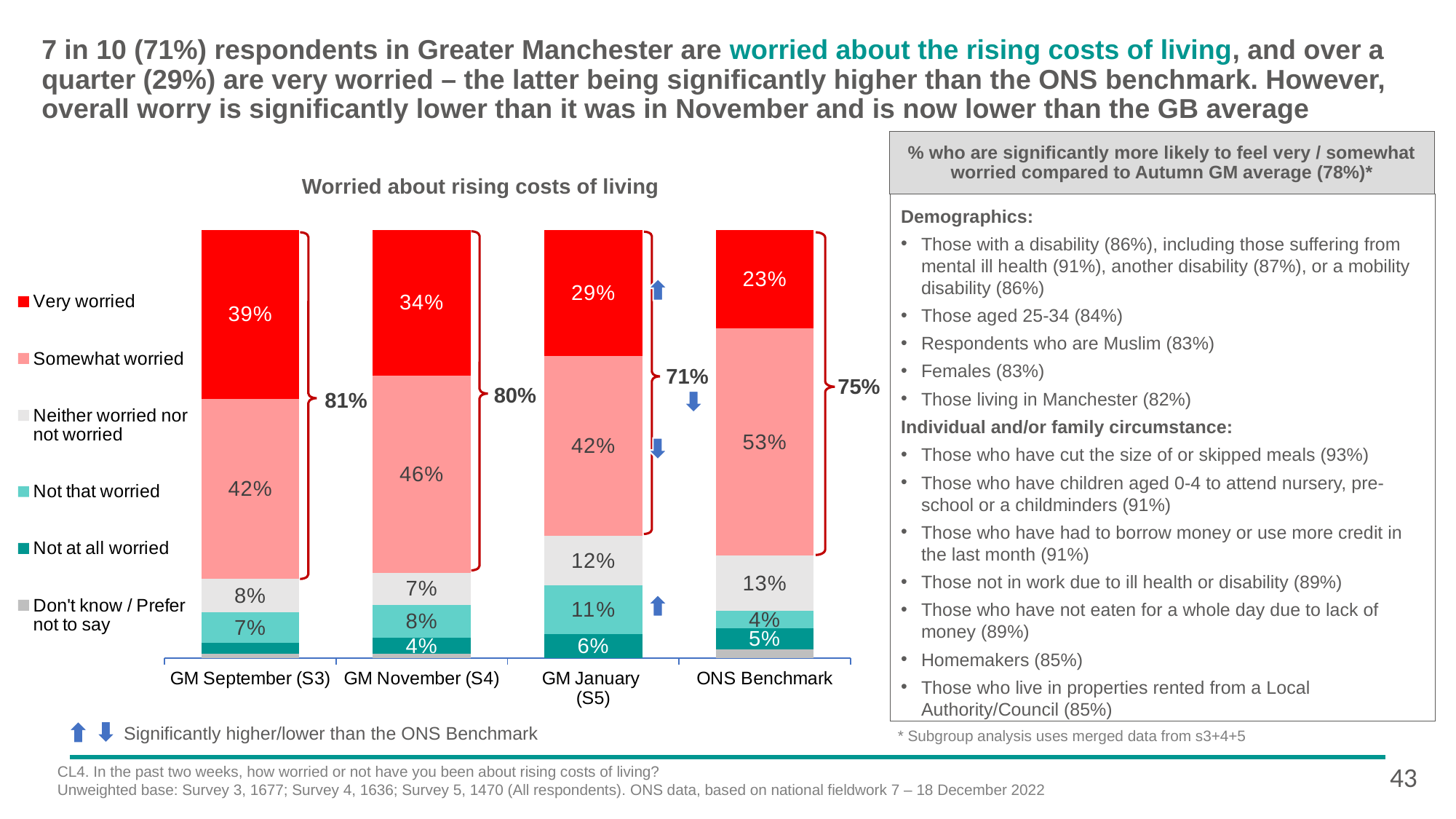
How does the 'Very worried' value change across the three GM surveys from September to January? It falls What is the 'Somewhat worried' value for the ONS Benchmark? 53% What is the difference between the 'Somewhat worried' values for GM November (S4) and GM January (S5)? 4% What is the 'Very worried' value for GM January (S5)? 29% What type of chart is shown on the slide? Stacked bar chart Which category has the lowest 'Very worried' value? ONS Benchmark Which is larger: the 'Neither worried nor not worried' value for GM January (S5) or for GM November (S4)? GM January (S5) How many series does the chart legend list? 6 What is the title of the chart? Worried about rising costs of living What is the combined 'Very worried' and 'Somewhat worried' total shown by the bracket for GM January (S5)? 71% How many categories are shown along the x axis of the chart? 4 Which category has the highest 'Very worried' value? GM September (S3)